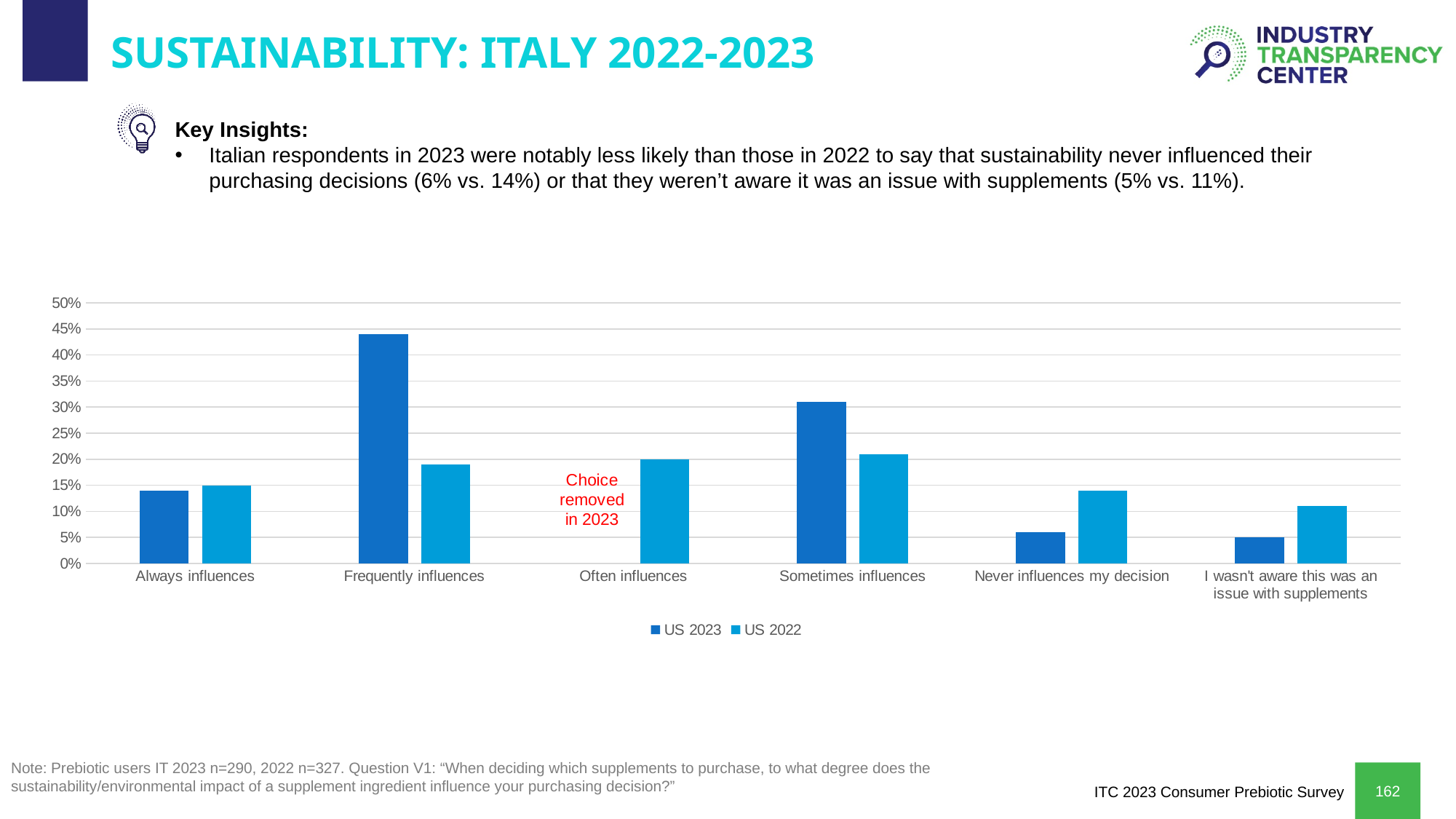
What is the 2022 value for 'Never influences my decision'? 14% For 'Sometimes influences', which is larger: the US 2023 bar or the US 2022 bar? US 2023 How many series does the legend list? 2 What is the 2023 value for 'Never influences my decision'? 6% What kind of chart is shown on the slide? Bar chart Which category has the highest US 2023 bar? Frequently influences What is the 2023 value for 'I wasn't aware this was an issue with supplements'? 5% Why is there no US 2023 bar for 'Often influences'? Choice removed in 2023 Is the US 2023 value for 'Frequently influences' greater or less than 40%? greater By how many percentage points did 'Never influences my decision' fall from 2022 to 2023? 8 percentage points How many categories are shown on the x axis? 6 What is the 2022 value for 'I wasn't aware this was an issue with supplements'? 11%